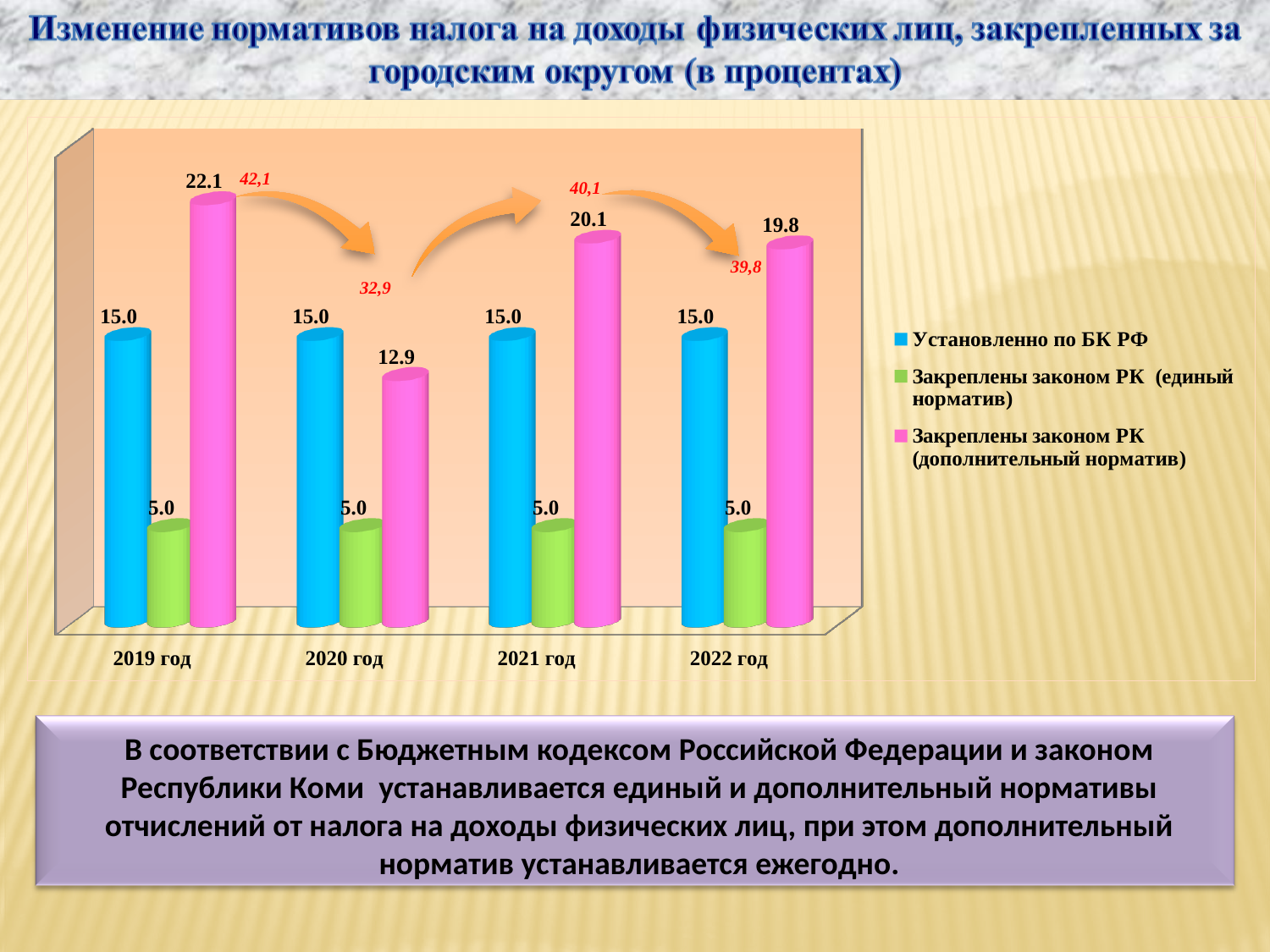
What is the value of the pink series (Закреплены законом РК (дополнительный норматив)) for 2019 год? 22.1 What is the value of the pink series (дополнительный норматив) for 2020 год? 12.9 How many series does the legend list? 3 Which is larger in 2021 год: the blue series (Установленно по БК РФ) or the pink series (дополнительный норматив)? the pink series (дополнительный норматив), 20.1 What kind of chart is shown on the slide? bar chart What is the difference between the pink series values for 2019 год and 2020 год? 9.2 In which year is the pink series (дополнительный норматив) highest? 2019 год What is the value of the pink series (дополнительный норматив) for 2022 год? 19.8 Which colour represents the series 'Закреплены законом РК (единый норматив)' in the legend? green How many years (categories) are shown on the x axis? 4 What is the value of the blue series (Установленно по БК РФ) for 2021 год? 15.0 In which year is the pink series (дополнительный норматив) lowest? 2020 год